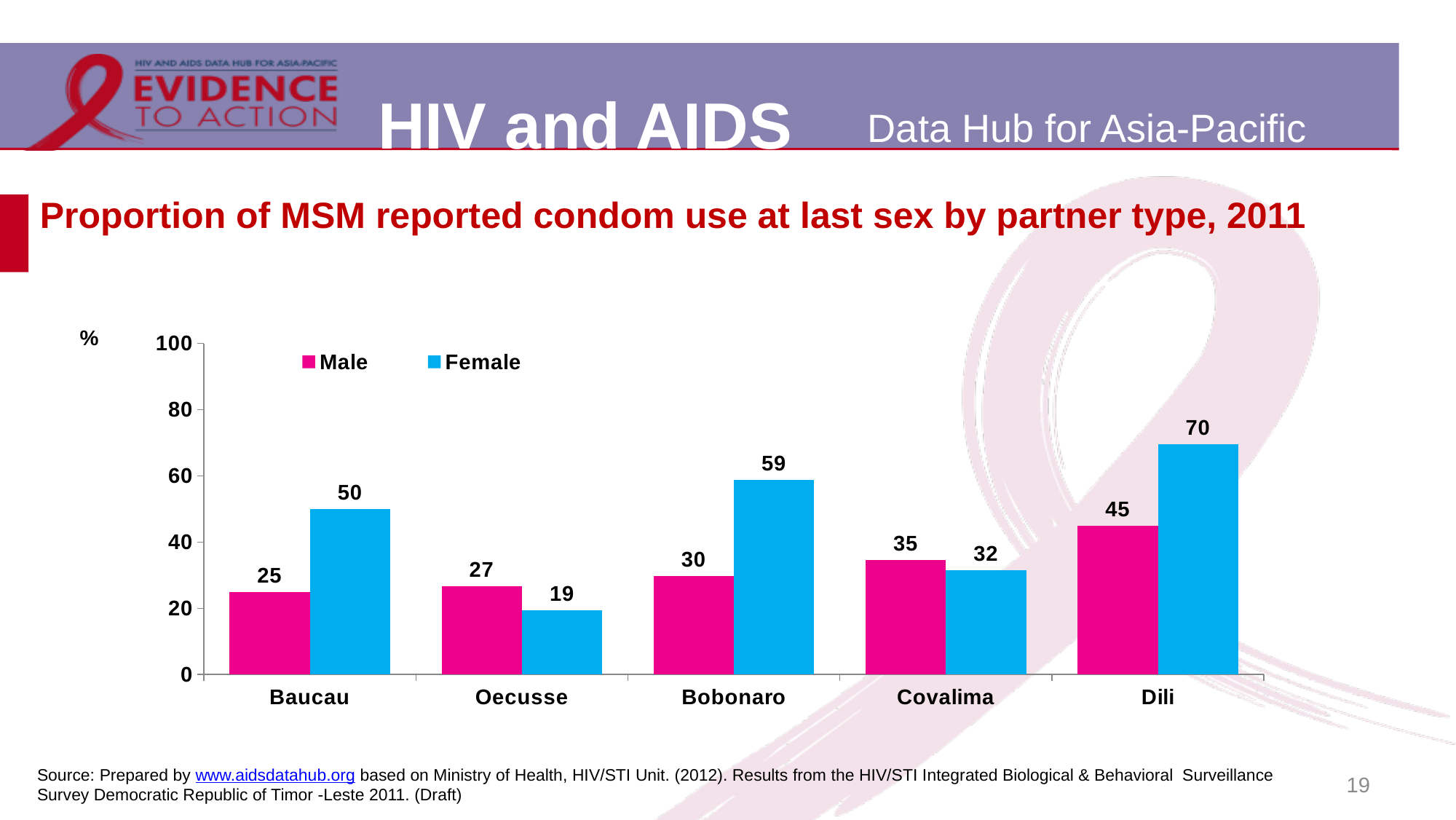
What is the difference between the Female and Male values in Baucau? 25 How many series does the legend list? 2 What is the difference between the Female values in Dili and Bobonaro? 11 What kind of chart is shown on the slide? Bar chart In Covalima, which is larger, the Male value or the Female value? Male What is the value for Male in Oecusse? 27 Which district has the lowest Female value? Oecusse What colour are the Female bars? Blue How many districts are shown on the x axis? 5 What is the value for Female in Bobonaro? 59 What is the value for Female in Dili? 70 Which district has the highest Male value? Dili